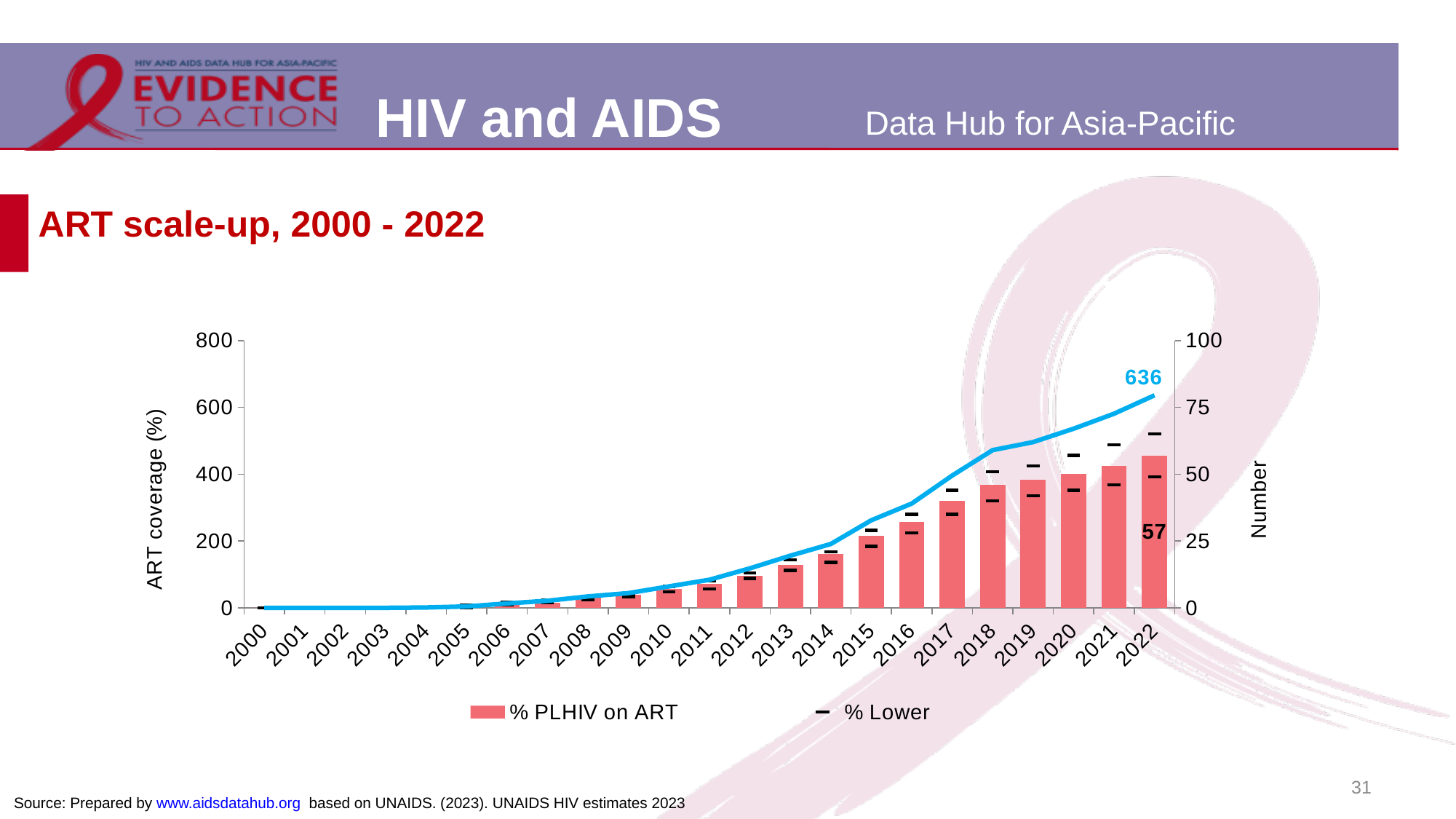
How many years are shown along the x axis? 23 What is the title of the chart on the slide? ART scale-up, 2000 - 2022 Which year has the larger % PLHIV on ART bar, 2010 or 2022? 2022 What kind of chart is shown on the slide? bar chart with a line What is the labelled value of the % PLHIV on ART bar for 2022? 57 Is the blue line value for 2018 greater or less than 400 on the left axis? greater Do the % PLHIV on ART bars rise or fall from 2000 to 2022? rise Is the % PLHIV on ART bar for 2010 greater or less than 25 on the right axis? less Is the % PLHIV on ART bar for 2018 greater or less than 50 on the right axis? less Which year has the tallest % PLHIV on ART bar? 2022 What value is labelled on the blue line for 2022? 636